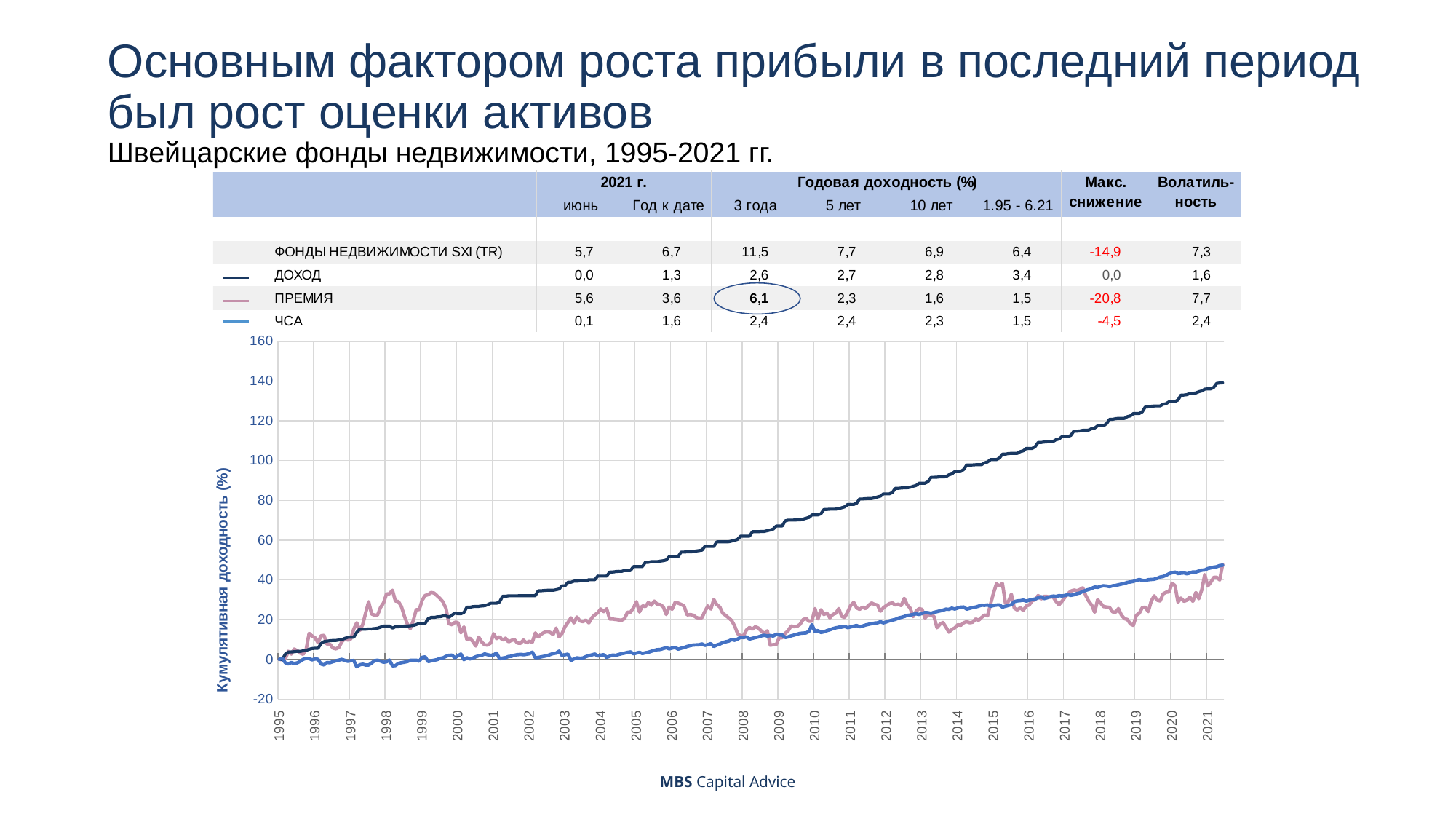
Does the ДОХОД series rise or fall from 1995 to 2021? rise What kind of chart is shown on the slide? line chart Is the value of the ЧСА series in 2005 greater or less than 20? less Is the value of the ДОХОД series in 2021 greater or less than 120? greater In 2015, which series has the larger value, ДОХОД or ЧСА? ДОХОД Is the value of the ПРЕМИЯ series in 2021 greater or less than 60? less How many series are plotted on the chart? 3 Which series has the highest cumulative return at the end of the chart in 2021? ДОХОД Which series has the lowest cumulative return in 2000? ЧСА What is the highest value shown on the vertical axis of the chart? 160 What is the label of the vertical axis of the chart? Кумулятивная доходность (%)